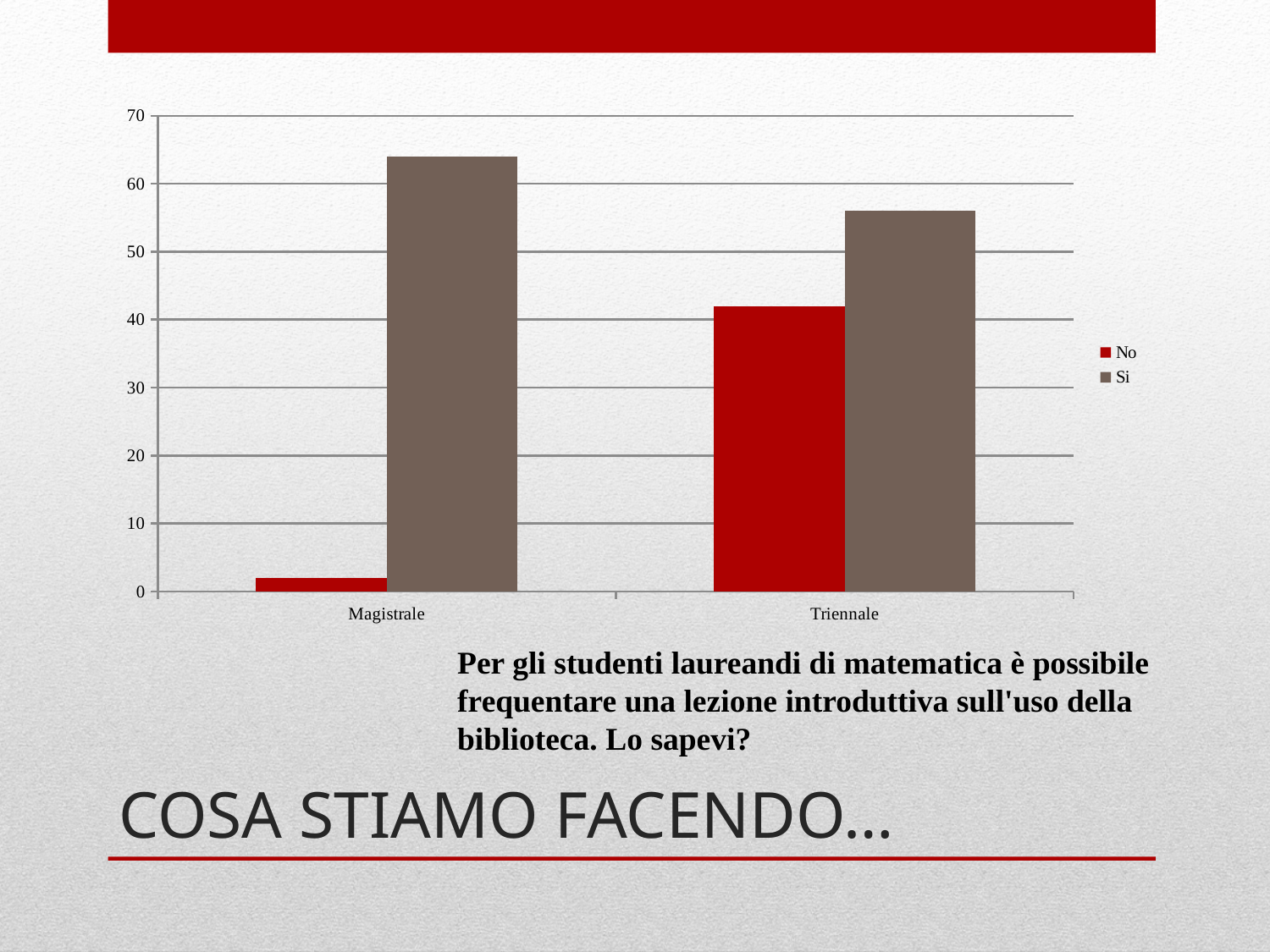
Is the 'Si' value for Triennale greater or less than 50? greater Which category has the higher 'Si' value, Magistrale or Triennale? Magistrale How many categories are shown on the x axis of the chart? 2 What are the two series listed in the chart's legend? No, Si What kind of chart is shown on the slide? bar chart Is the 'No' value for Triennale greater or less than 40? greater How many series does the chart's legend list? 2 Which category has the lower 'No' value, Magistrale or Triennale? Magistrale Which colour represents the 'No' series in the chart? red Is the 'No' value for Magistrale greater or less than 10? less For Triennale, which series has the larger value, 'No' or 'Si'? Si